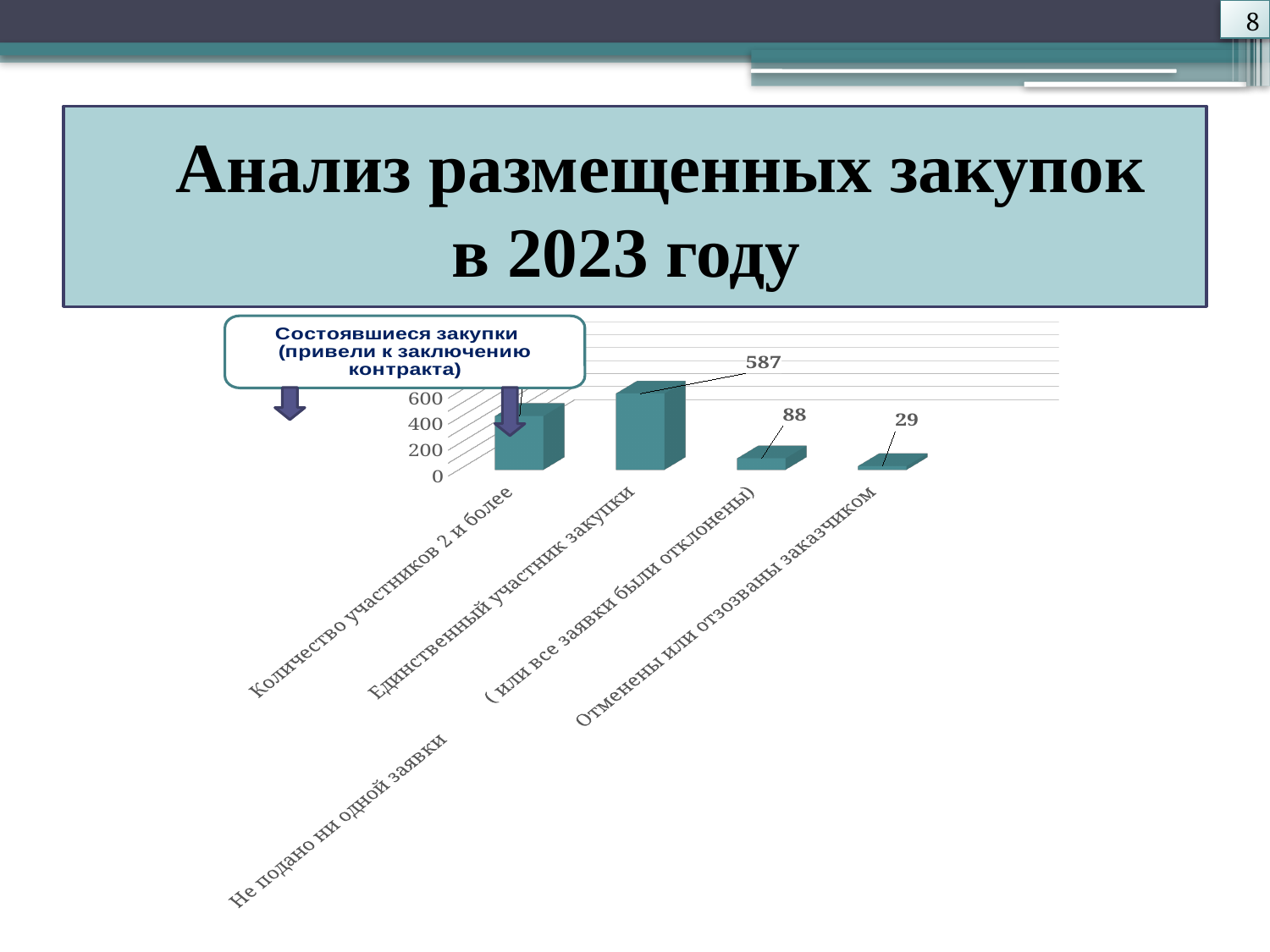
What is the title of the slide containing the chart? Анализ размещенных закупок в 2023 году What is the value for "Единственный участник закупки"? 587 Which category has the highest value? Единственный участник закупки Which category has the lowest value? Отменены или отозваны заказчиком How many categories are shown in the chart? 4 What is the difference between the values for "Единственный участник закупки" and "Не подано ни одной заявки (или все заявки были отклонены)"? 499 What kind of chart is shown on the slide? bar chart What is the value for "Не подано ни одной заявки (или все заявки были отклонены)"? 88 What is the difference between the values for "Не подано ни одной заявки (или все заявки были отклонены)" and "Отменены или отозваны заказчиком"? 59 Which is larger: the value for "Количество участников 2 и более" or the value for "Единственный участник закупки"? Единственный участник закупки What is the value for "Отменены или отозваны заказчиком"? 29 Is the value for "Количество участников 2 и более" greater or less than 200? greater